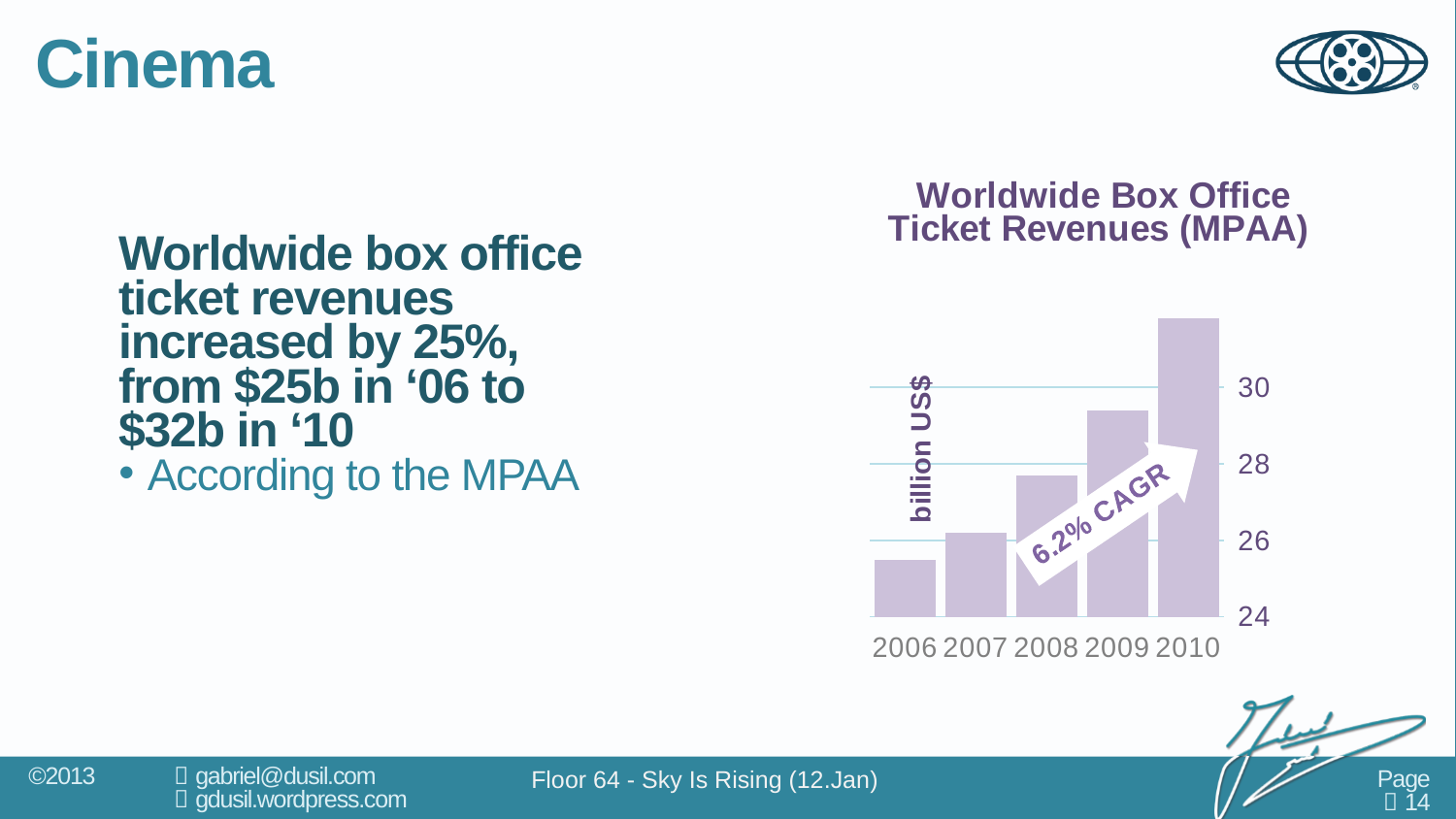
What is the label on the y axis of the chart? billion US$ What growth rate is written on the arrow across the chart? 6.2% CAGR What kind of chart is shown on the slide? bar chart How many years are plotted on the x axis of the Worldwide Box Office Ticket Revenues chart? 5 Which year has the larger value, 2007 or 2009? 2009 Which year has the highest worldwide box office ticket revenue in the chart? 2010 Is the value for 2010 greater or less than 30? greater Is the value for 2009 greater or less than 28? greater Which year has the lowest worldwide box office ticket revenue in the chart? 2006 Do the box office ticket revenues rise or fall from 2006 to 2010? rise Is the value for 2008 greater or less than 28? less